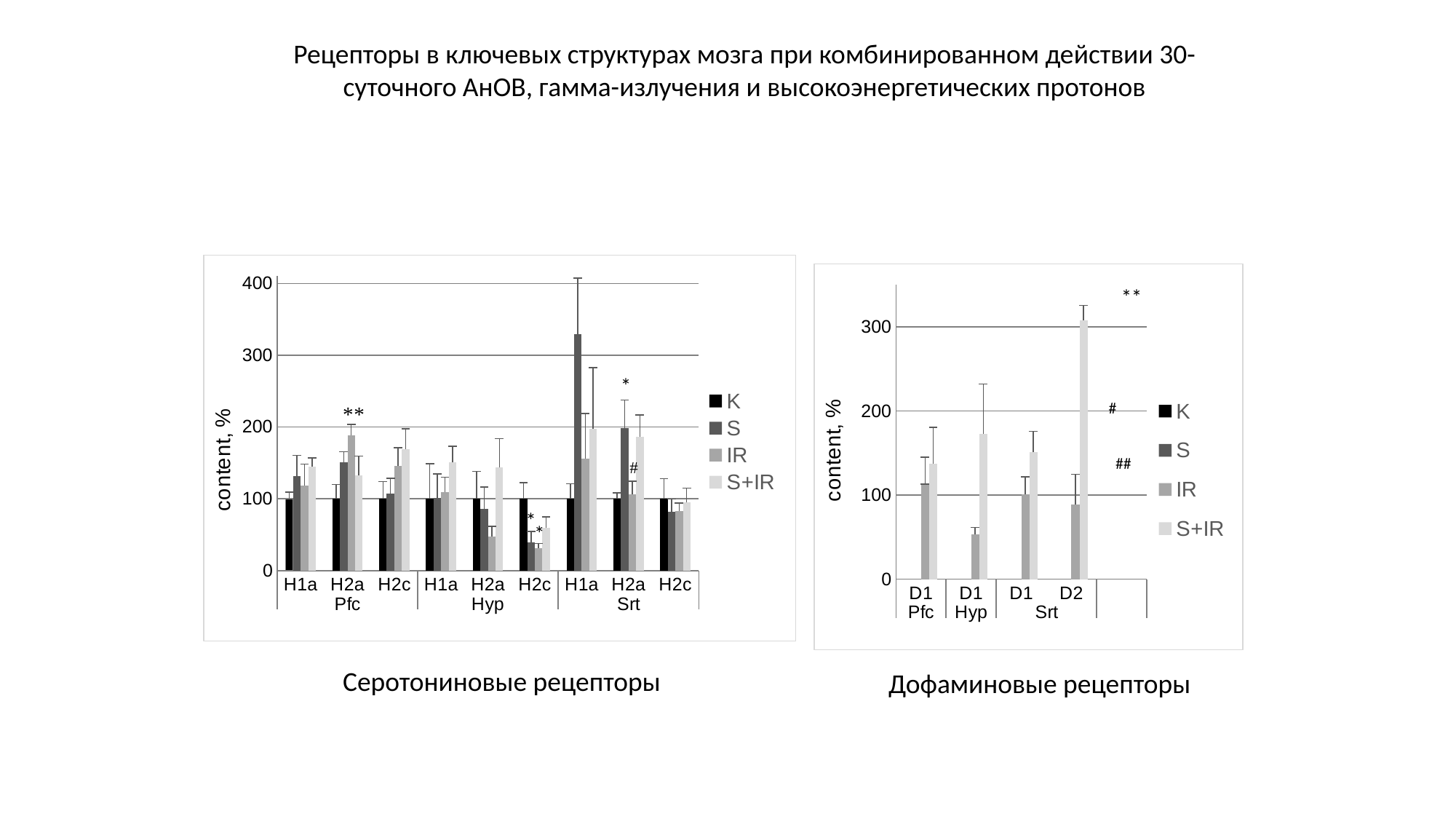
What is the y-axis label of the 'Дофаминовые рецепторы' chart? content, % In the 'Дофаминовые рецепторы' chart, which category has the highest bar? D2 Srt In the 'Серотониновые рецепторы' chart, is the S+IR value for H2c in Hyp greater or less than 100? less How many series does the legend of the 'Дофаминовые рецепторы' chart list? 4 In the 'Серотониновые рецепторы' chart, is the S value for H1a in Srt greater or less than 300? greater In the 'Дофаминовые рецепторы' chart, is the S+IR value for D2 in Srt greater or less than 200? greater In the 'Серотониновые рецепторы' chart, which series has the highest bar for H1a in Srt? S How many categories are shown along the x axis of the 'Дофаминовые рецепторы' chart? 4 How many categories are shown along the x axis of the 'Серотониновые рецепторы' chart? 9 In the 'Серотониновые рецепторы' chart, for H2a in Hyp, which is larger: the S value or the S+IR value? S+IR What kind of chart is the 'Серотониновые рецепторы' chart on the left? bar chart